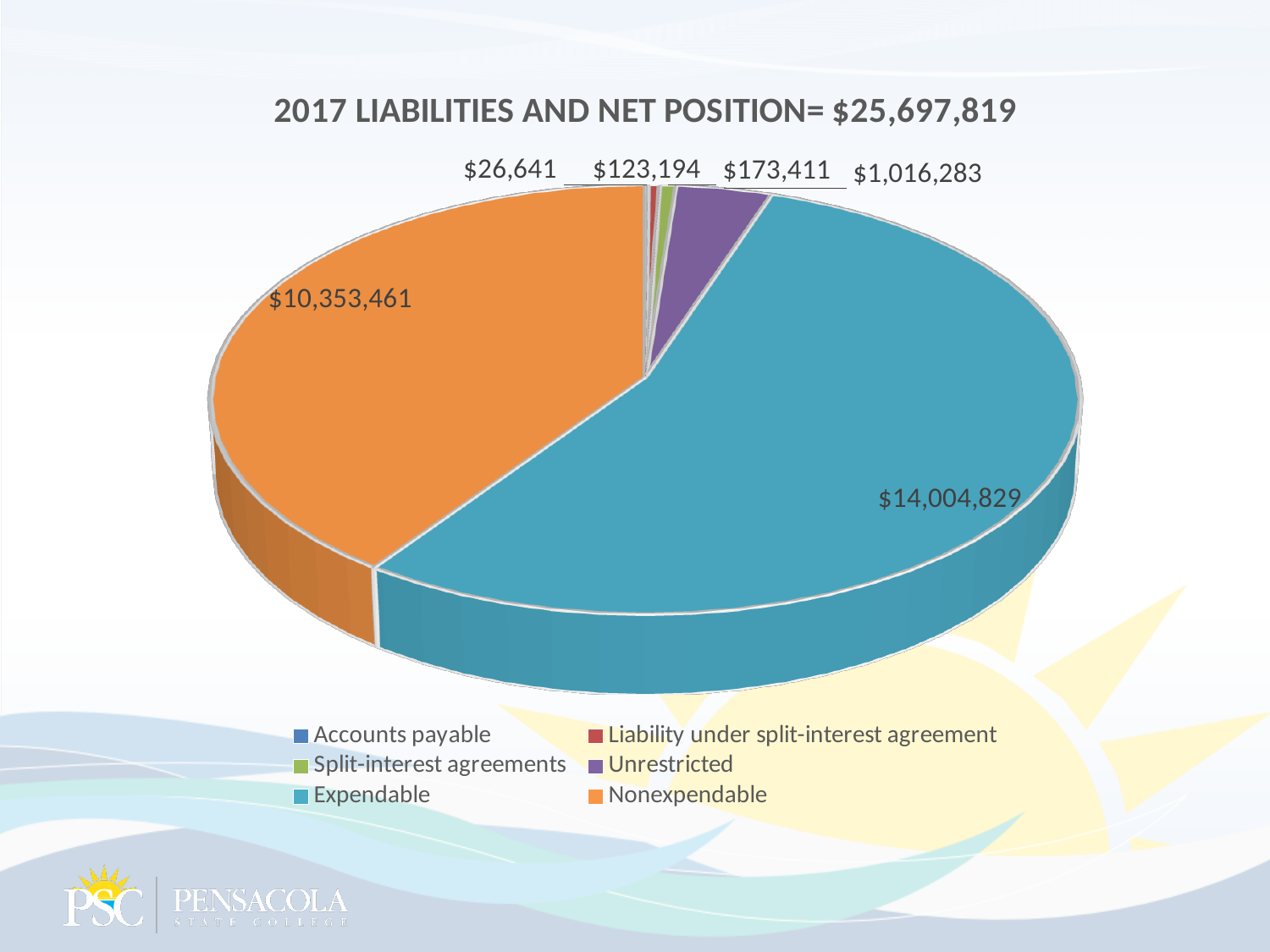
What is the value of the Nonexpendable slice? $10,353,461 What is the difference between the Expendable and Nonexpendable values? $3,651,368 Which category has the largest slice of the pie? Expendable What is the value of the Accounts payable slice? $26,641 What is the value of the Expendable slice? $14,004,829 What type of chart is shown on the slide? Pie chart How many categories does the legend list? 6 What is the value of the Liability under split-interest agreement slice? $123,194 What total is stated in the chart title? $25,697,819 Which is larger, Split-interest agreements or Liability under split-interest agreement? Split-interest agreements Which category has the smallest slice of the pie? Accounts payable What is the value of the Unrestricted slice? $1,016,283